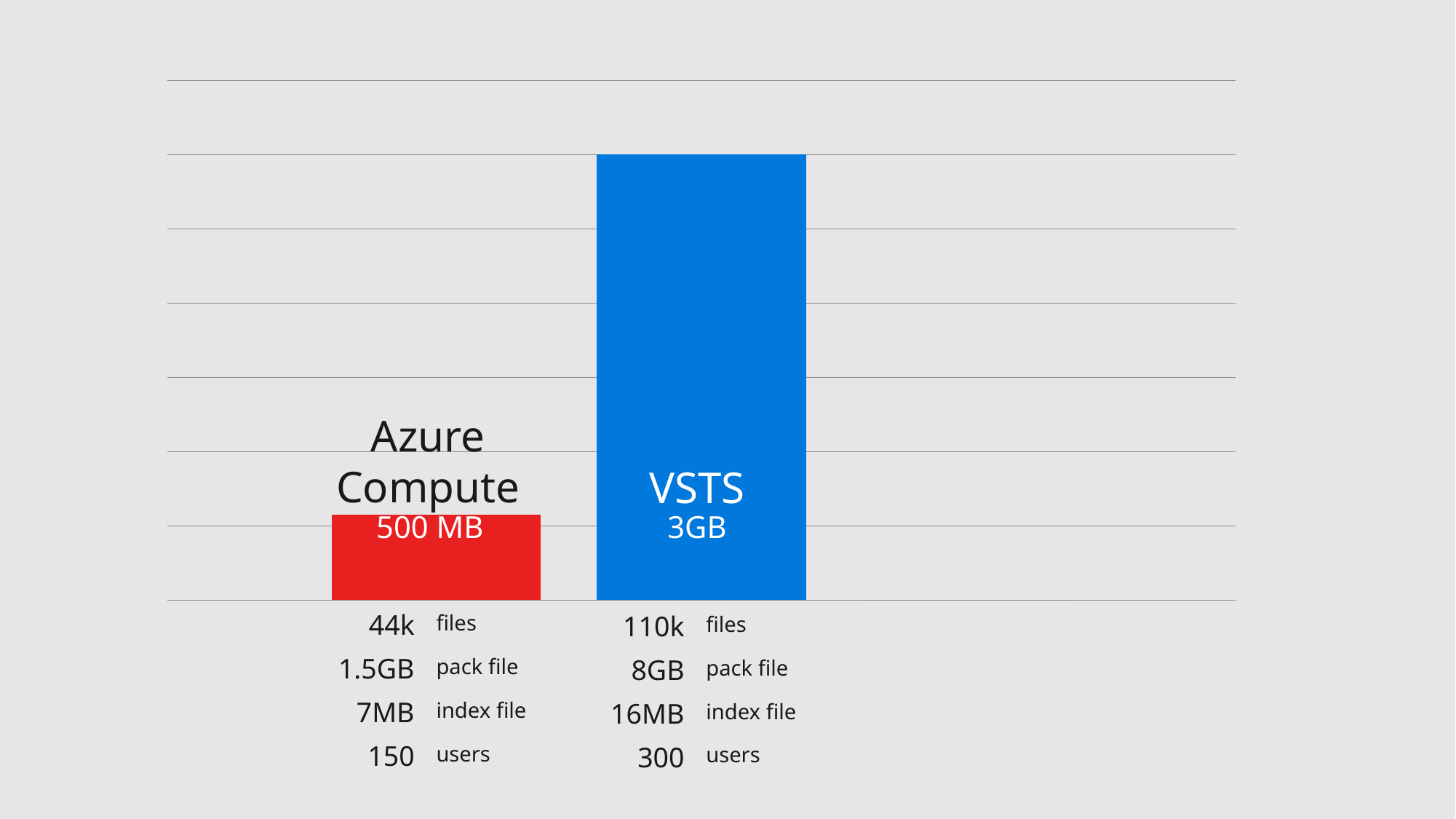
Which bar is the tallest? VSTS What kind of chart is shown on the slide? Bar chart What value is shown on the Azure Compute bar? 500 MB How many files are listed under the VSTS bar? 110k What pack file size is listed under the Azure Compute bar? 1.5GB What colour is the VSTS bar? Blue How many users are listed under the VSTS bar? 300 What value is shown on the VSTS bar? 3GB Which is larger, the Azure Compute bar or the VSTS bar? VSTS How many bars are plotted on the chart? 2 Which bar is the shortest? Azure Compute What colour is the Azure Compute bar? Red